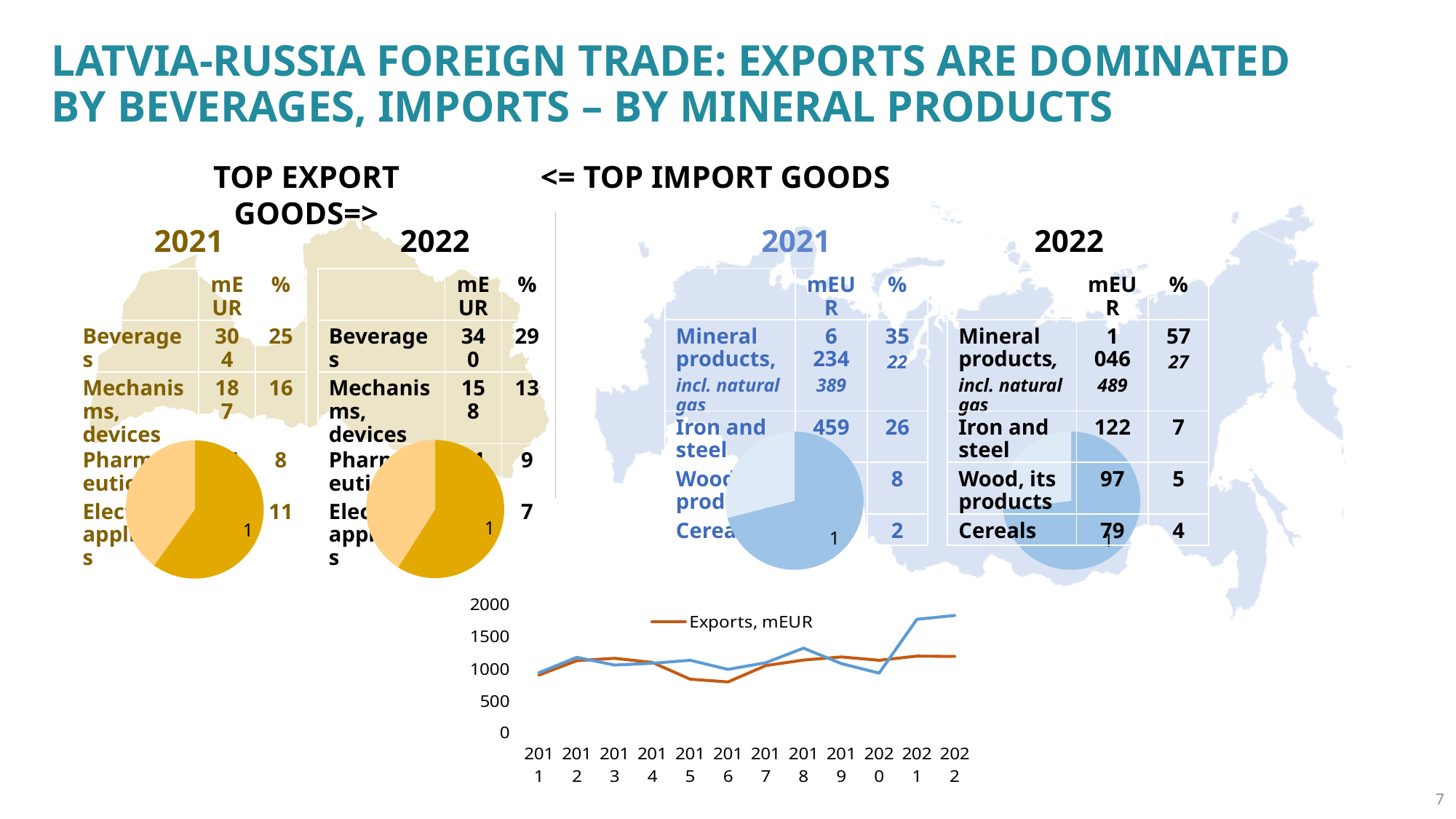
How many years are shown on the x axis of the line chart at the bottom of the slide? 12 What legend entry is shown on the line chart at the bottom of the slide? Exports, mEUR What colour are the pie charts under the TOP EXPORT GOODS tables? yellow/orange What kind of charts are overlaid on the export and import tables in the middle of the slide? pie charts On the line chart at the bottom of the slide, is the value of the blue line for 2022 greater or less than 1500? greater On the line chart at the bottom of the slide, which line is higher in 2022, the blue line or the orange Exports line? the blue line On the line chart at the bottom of the slide, is the value of the orange Exports line for 2016 greater or less than 1000? less On the line chart at the bottom of the slide, does the blue line rise or fall from 2020 to 2022? rises How many pie charts are shown on the slide? 4 On the line chart at the bottom of the slide, is the value of the blue line for 2018 greater or less than 1000? greater What kind of chart is shown at the bottom of the slide with years 2011 to 2022 on the x axis? line chart